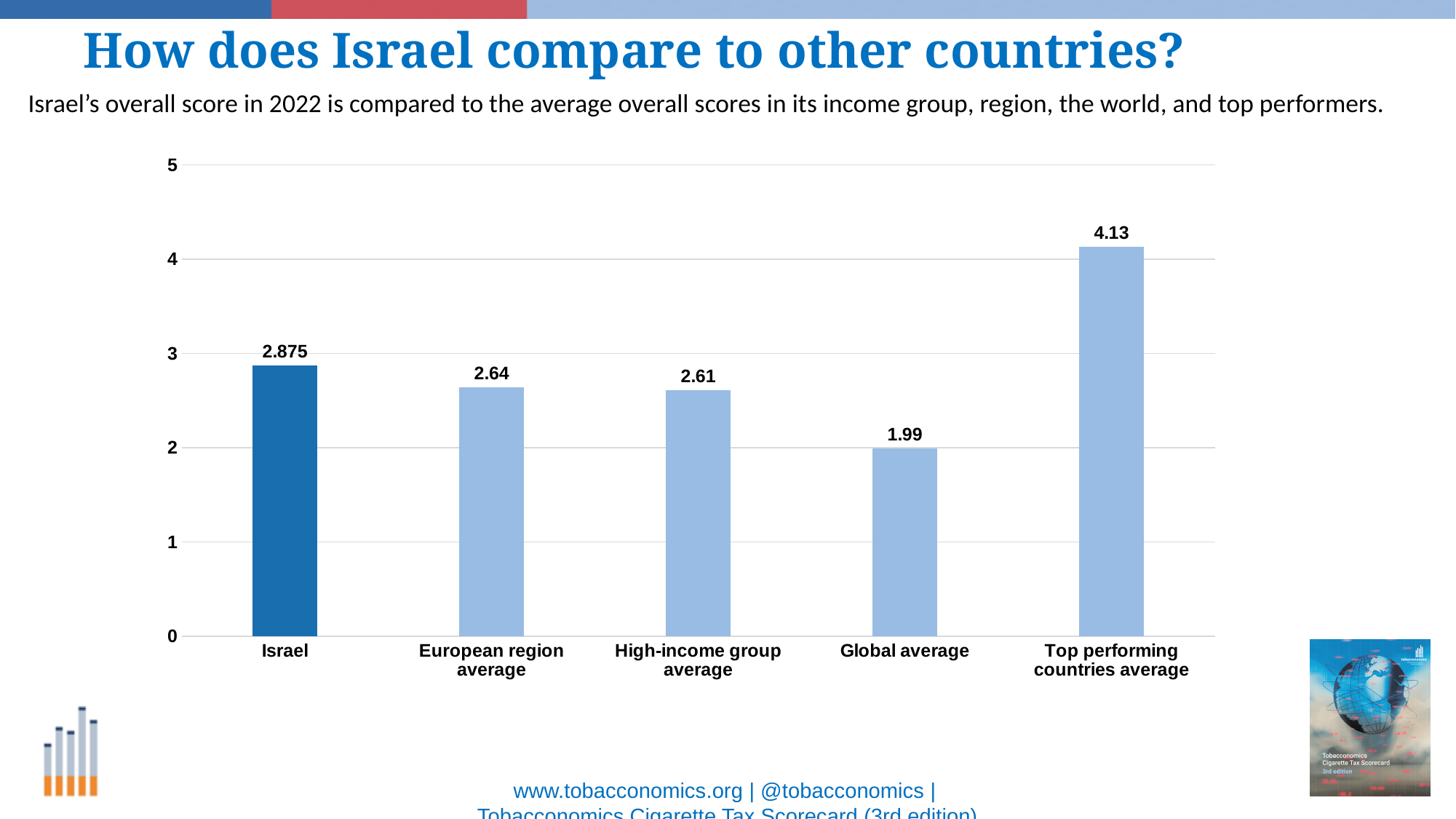
Is the value for Global average greater or less than 2? less Which is larger, Israel or the European region average? Israel What is the difference between the Top performing countries average and Israel? 1.255 What is the difference between the European region average and the Global average? 0.65 What kind of chart is shown on the slide? Bar chart What is the value for Top performing countries average? 4.13 How many categories are shown in the chart? 5 What is the value for Global average? 1.99 What is the value for Israel? 2.875 Which category has the lowest value? Global average Which category has the highest value? Top performing countries average What is the value for High-income group average? 2.61